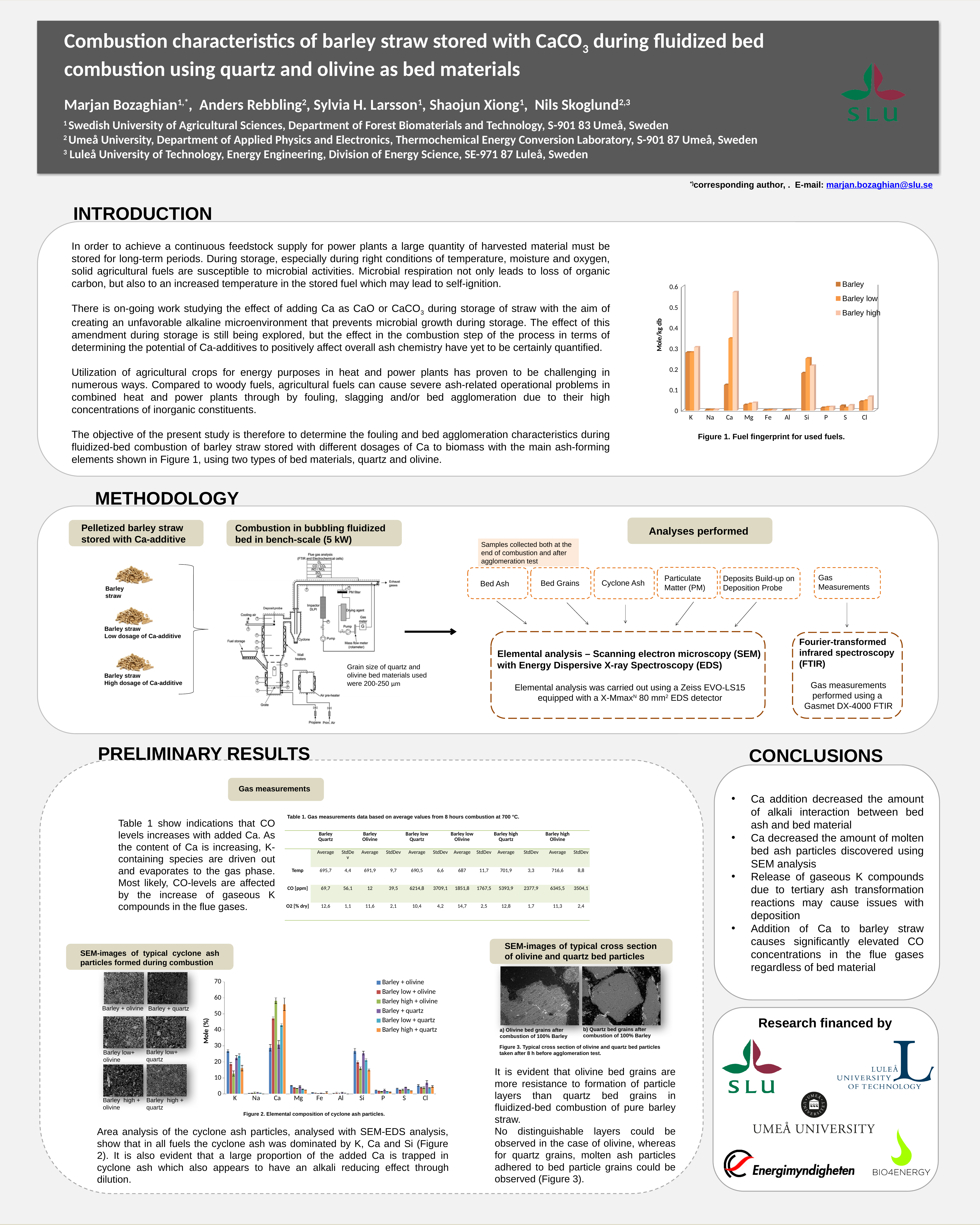
In Figure 1 (Fuel fingerprint for used fuels), which is larger for Ca: the Barley series or the Barley high series? Barley high In Figure 1 (Fuel fingerprint for used fuels), is the value for Ca in the Barley high series greater or less than 0.5? greater In Figure 1 (Fuel fingerprint for used fuels), what is the label of the y axis? Mole/kg db In Figure 1 (Fuel fingerprint for used fuels), how many series does the legend list? 3 In Figure 1 (Fuel fingerprint for used fuels), what kind of chart is shown? bar chart In Figure 2 (Elemental composition of cyclone ash particles), what kind of chart is shown? bar chart In Figure 1 (Fuel fingerprint for used fuels), is the value for Ca in the Barley series greater or less than 0.2? less In Figure 2 (Elemental composition of cyclone ash particles), how many series does the legend list? 6 In Figure 1 (Fuel fingerprint for used fuels), which element has the highest value for the Barley high series? Ca In Figure 2 (Elemental composition of cyclone ash particles), what is the label of the y axis? Mole (%) In Figure 1 (Fuel fingerprint for used fuels), how many elements are shown on the x axis? 10 In Figure 2 (Elemental composition of cyclone ash particles), is the value for Ca in the Barley low + olivine series greater or less than 50? less